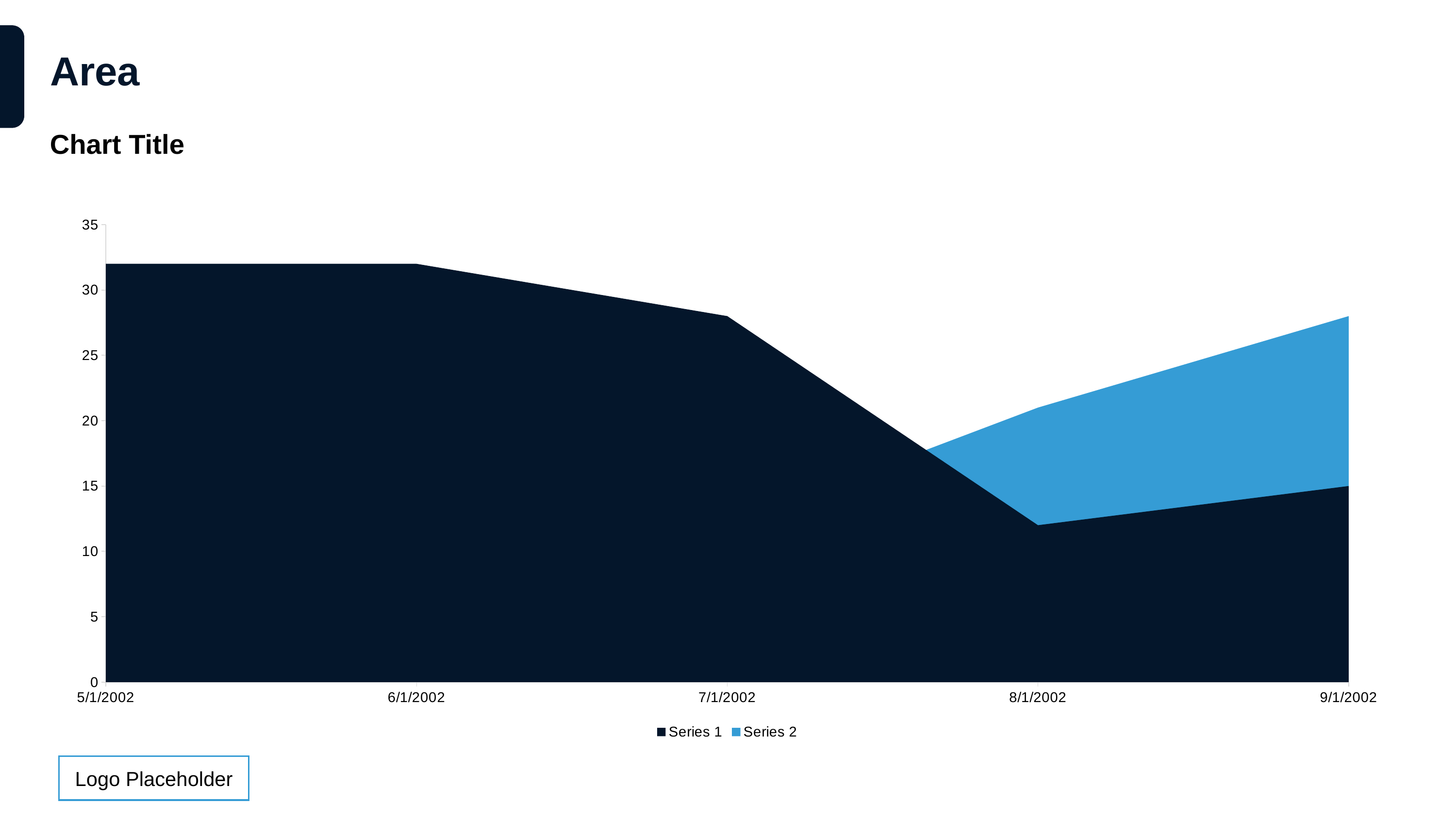
What are the names of the series in the legend? Series 1 and Series 2 Is the value for Series 1 at 8/1/2002 greater or less than 15? less How many series does the legend list? 2 At which date is Series 1 at its lowest? 8/1/2002 What kind of chart is shown on the slide? Area chart Does Series 1 rise or fall from 5/1/2002 to 8/1/2002? Fall What is the title of the chart? Chart Title Which is larger for Series 1: the value at 5/1/2002 or the value at 8/1/2002? 5/1/2002 Is the value for Series 1 at 7/1/2002 greater or less than 25? greater Is the value for Series 1 at 5/1/2002 greater or less than 30? greater How many dates are shown on the x axis? 5